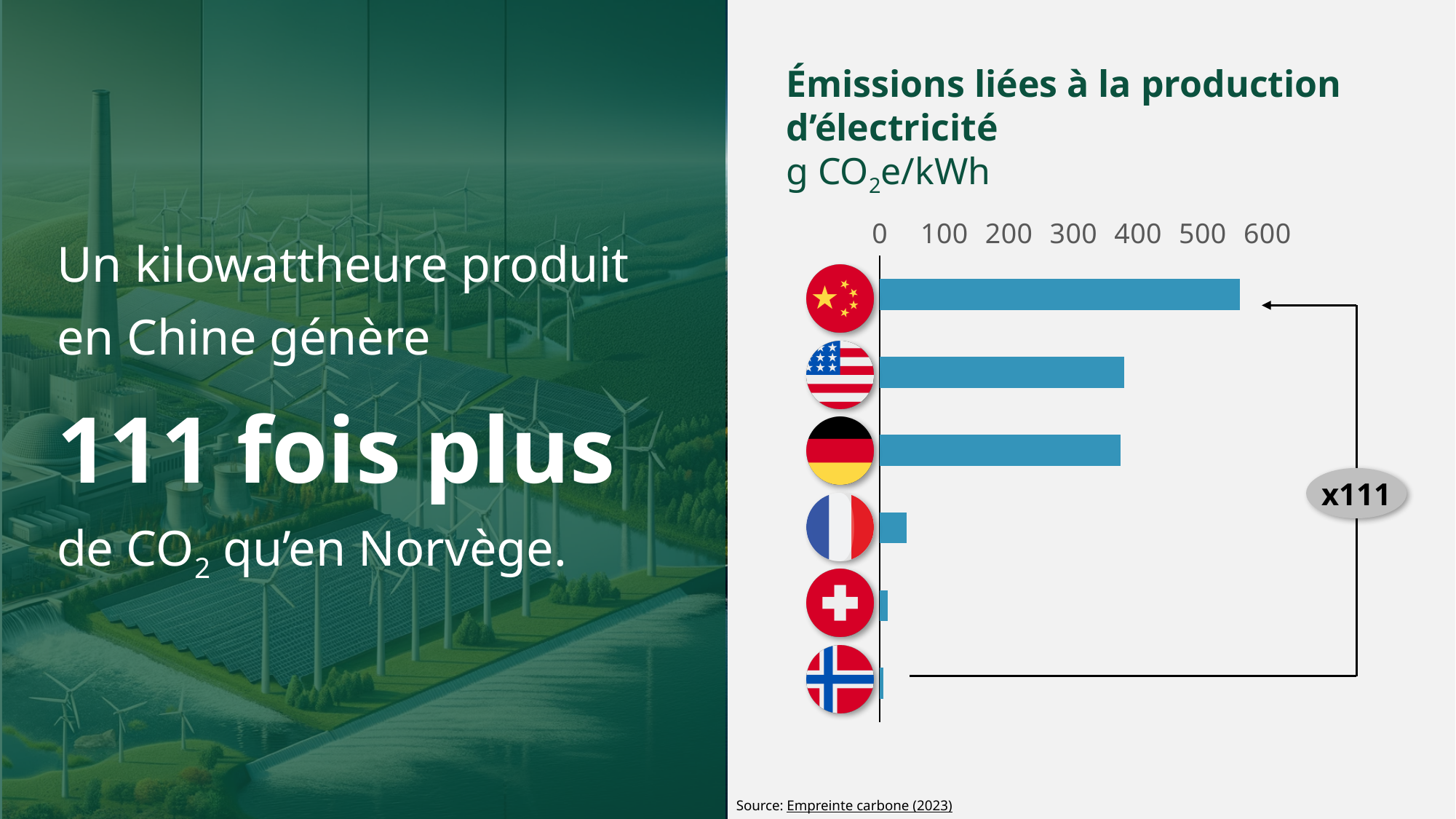
How many countries are shown in the chart? 6 What unit is used for the values in the chart? g CO2e/kWh Which country has the lowest electricity production emissions in the chart? Norway Is the value for Germany greater or less than 300? greater Which has a larger value, China or France? China Is the value for the United States greater or less than 400? less What factor is shown in the annotation between the China and Norway bars? x111 Is the value for France greater or less than 100? less What kind of chart is shown on the slide? bar chart Which country has the highest electricity production emissions in the chart? China